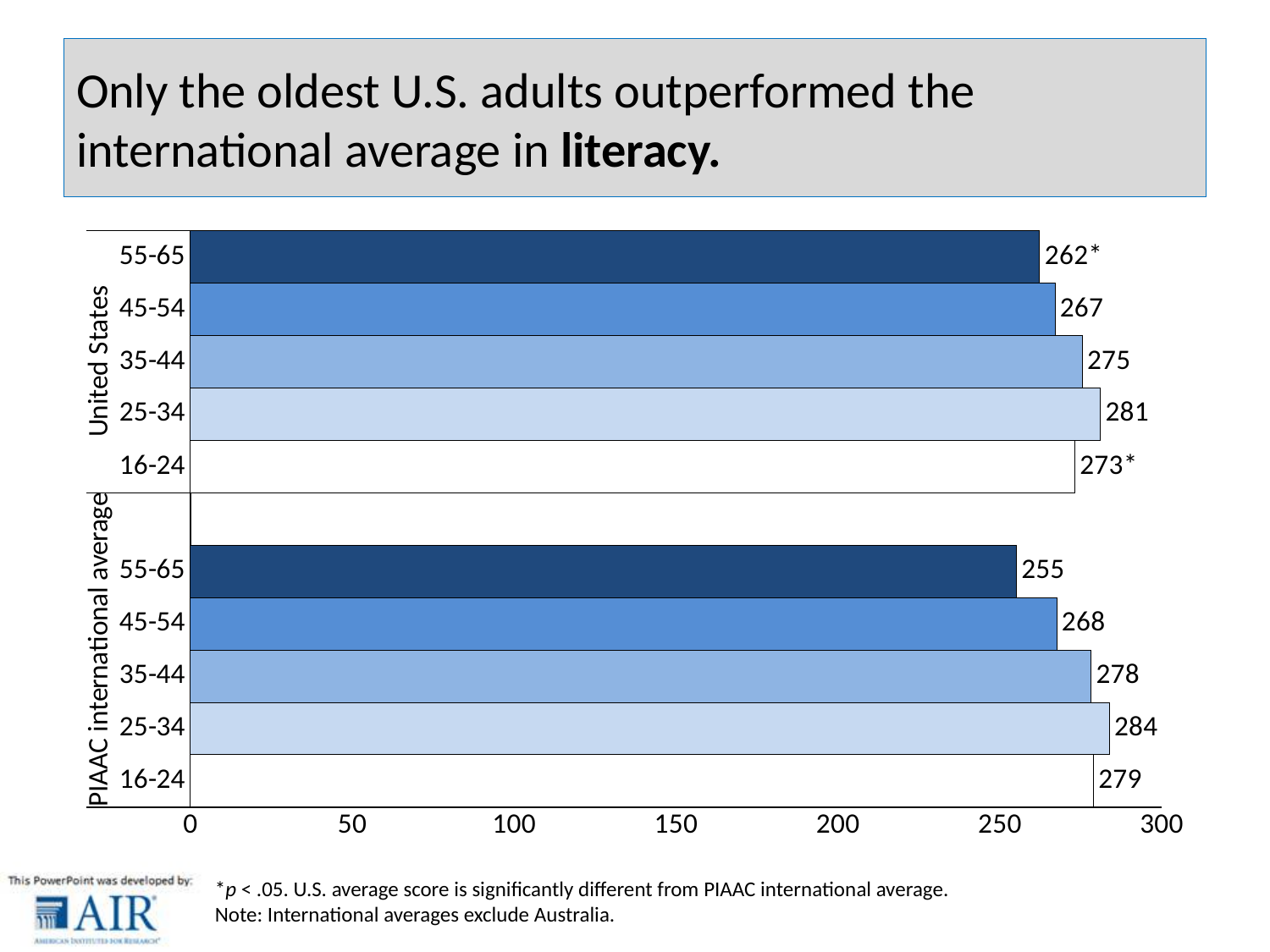
What is the PIAAC international average literacy score for the 16-24 age group? 279 What kind of chart is shown on the slide? bar chart What is the difference between the United States and PIAAC international average literacy scores for the 55-65 age group? 7 What is the PIAAC international average literacy score for the 55-65 age group? 255 How many age groups are shown for each of the two groups in the chart? 5 Which is larger, the United States score for 45-54 or the PIAAC international average score for 45-54? PIAAC international average What is the difference between the PIAAC international average and United States literacy scores for the 35-44 age group? 3 What is the literacy score for the United States 25-34 age group? 281 Which age group has the highest literacy score in the PIAAC international average? 25-34 What is the maximum value shown on the horizontal axis? 300 What is the data label shown for the United States 55-65 age group? 262* Which age group has the lowest literacy score in the United States? 55-65